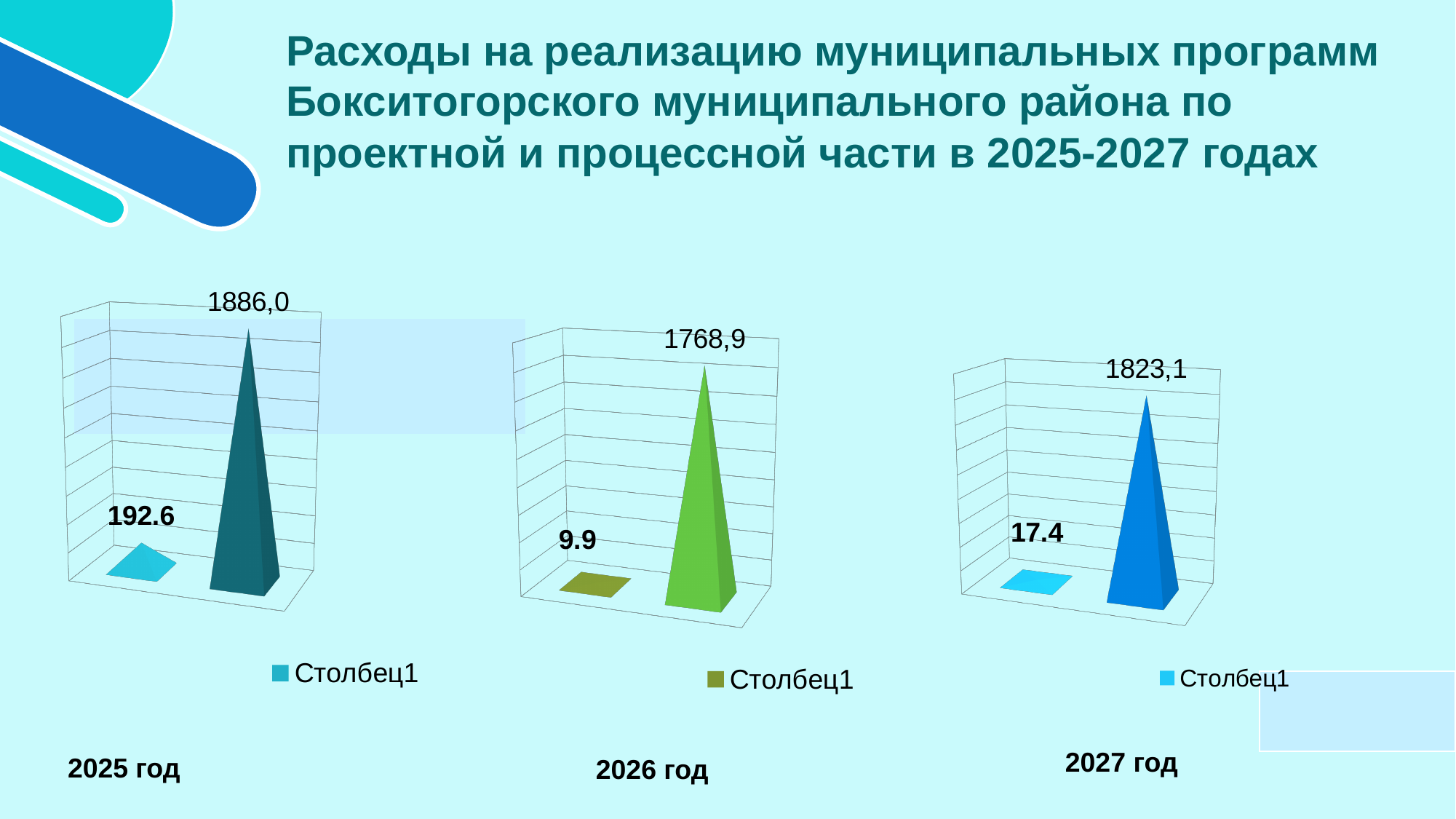
How many bars are plotted in the 2025 год chart? 2 Across the three charts, which year has the lowest value for its shorter bar? 2026 год In the 2025 год chart, what value is printed above the taller bar? 1886,0 Across the three charts, which year has the highest value for its taller bar? 2025 год In the 2026 год chart, what value is printed above the taller bar? 1768,9 In the 2027 год chart, what value is printed above the shorter bar? 17.4 In the 2026 год chart, what value is printed above the shorter bar? 9.9 How many series does the legend of the 2026 год chart list? 1 Which is larger: the taller bar in the 2026 год chart or the taller bar in the 2027 год chart? 2027 год (1823,1) In the 2027 год chart, what value is printed above the taller bar? 1823,1 What type of chart is used for the 2027 год data? Bar chart In the 2025 год chart, what value is printed above the shorter bar? 192.6